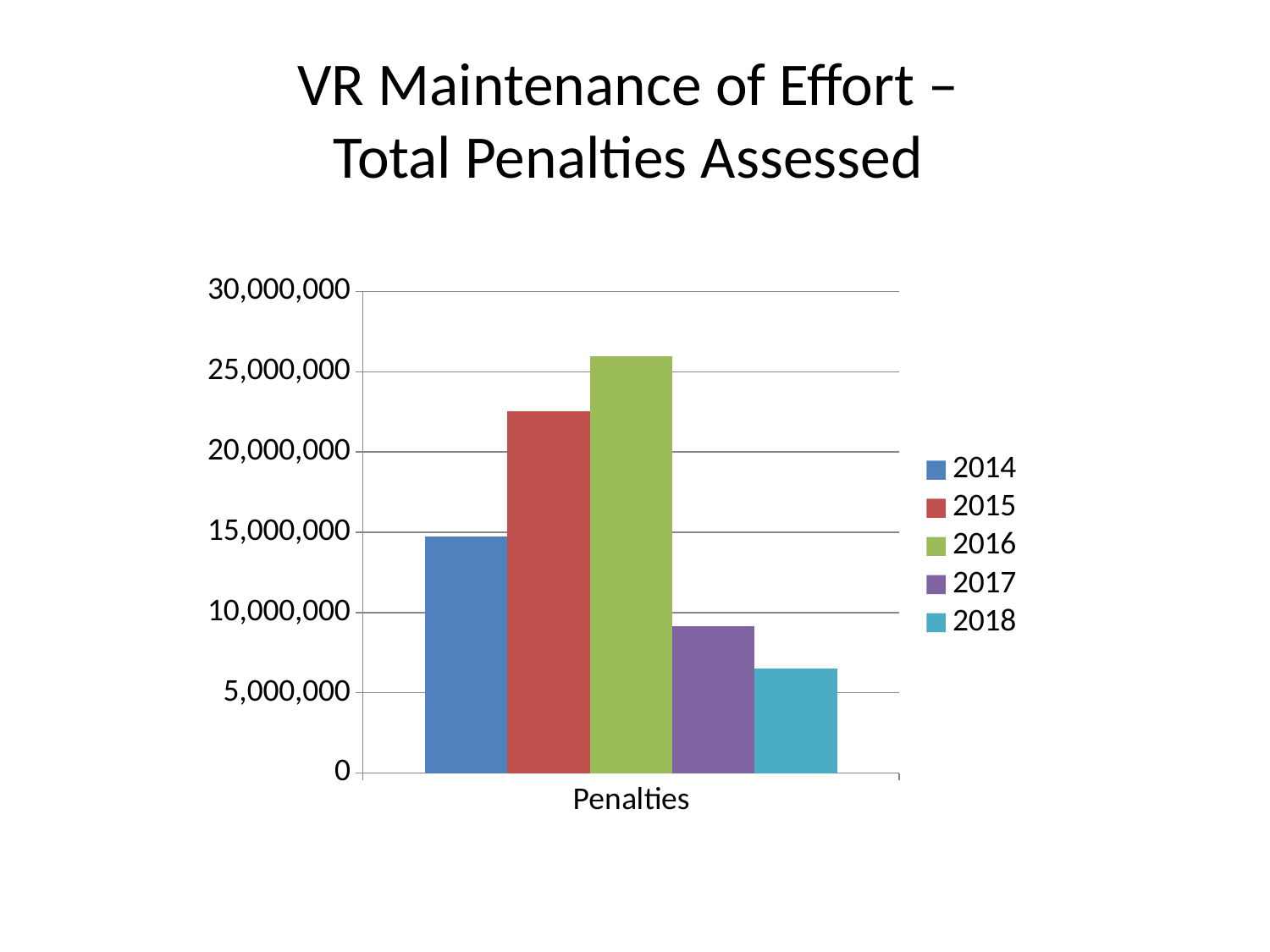
What kind of chart is shown on the slide? bar chart Is the value for 2015 greater or less than 20,000,000? greater Is the value for 2016 greater or less than 25,000,000? greater Which year has the highest penalties? 2016 Is the value for 2014 greater or less than 15,000,000? less Which is larger, the penalties for 2015 or for 2017? 2015 What is the title of the chart on the slide? VR Maintenance of Effort – Total Penalties Assessed What is the label on the x axis category? Penalties Which year has the lowest penalties? 2018 How many series does the legend list? 5